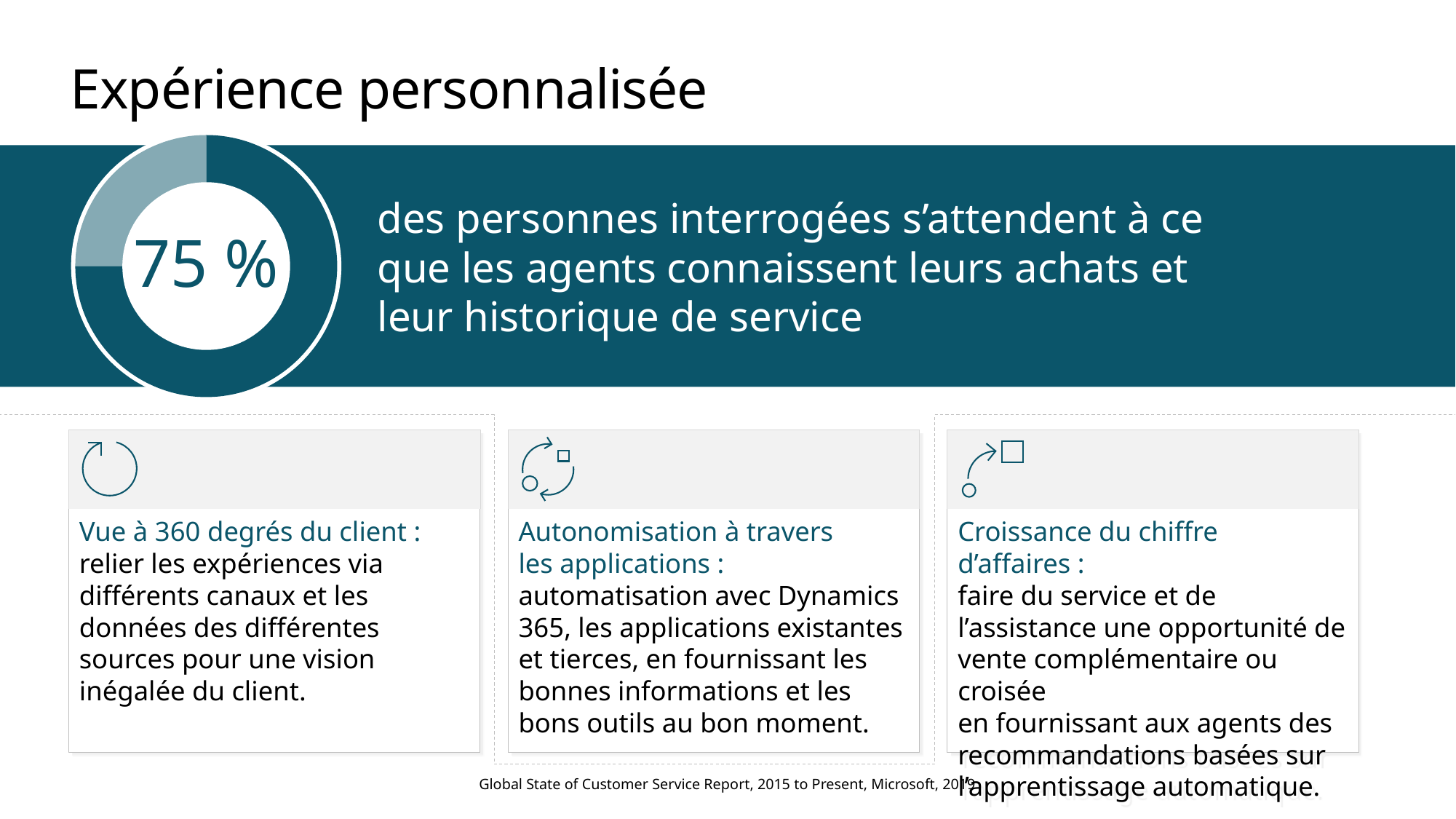
What is the source cited for the 75 % statistic? Global State of Customer Service Report, 2015 to Present, Microsoft, 2019 What share of the donut is not covered by the 75 % segment? 25 % What percentage is shown in the centre of the donut chart? 75 % What kind of chart is shown on the slide? donut chart According to the slide, what do 75 % of respondents expect? that agents know their purchases and service history How many segments does the donut chart have? 2 Is the value shown in the donut chart greater or less than 50%? greater